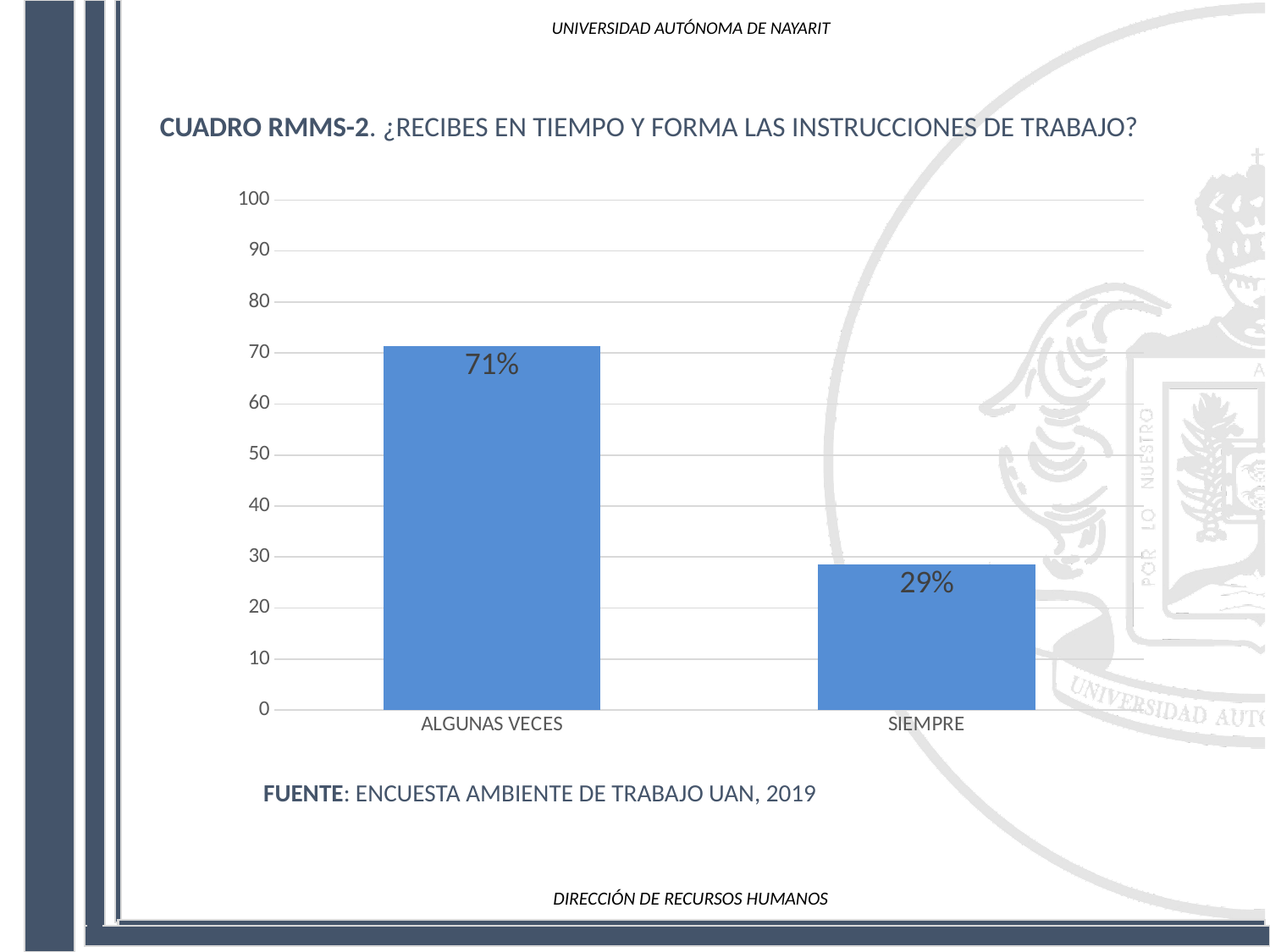
What is the difference between the values for ALGUNAS VECES and SIEMPRE? 42% What is the value for ALGUNAS VECES? 71% What is the source cited below the chart? ENCUESTA AMBIENTE DE TRABAJO UAN, 2019 Which category has the lowest value? SIEMPRE Is the value for ALGUNAS VECES greater or less than 70? greater What kind of chart is shown on the slide? bar chart Which is larger, the value for ALGUNAS VECES or the value for SIEMPRE? ALGUNAS VECES How many categories are shown on the x axis? 2 What is the value for SIEMPRE? 29% Is the value for SIEMPRE greater or less than 30? less What question does the chart title ask? ¿RECIBES EN TIEMPO Y FORMA LAS INSTRUCCIONES DE TRABAJO? Which category has the highest value? ALGUNAS VECES